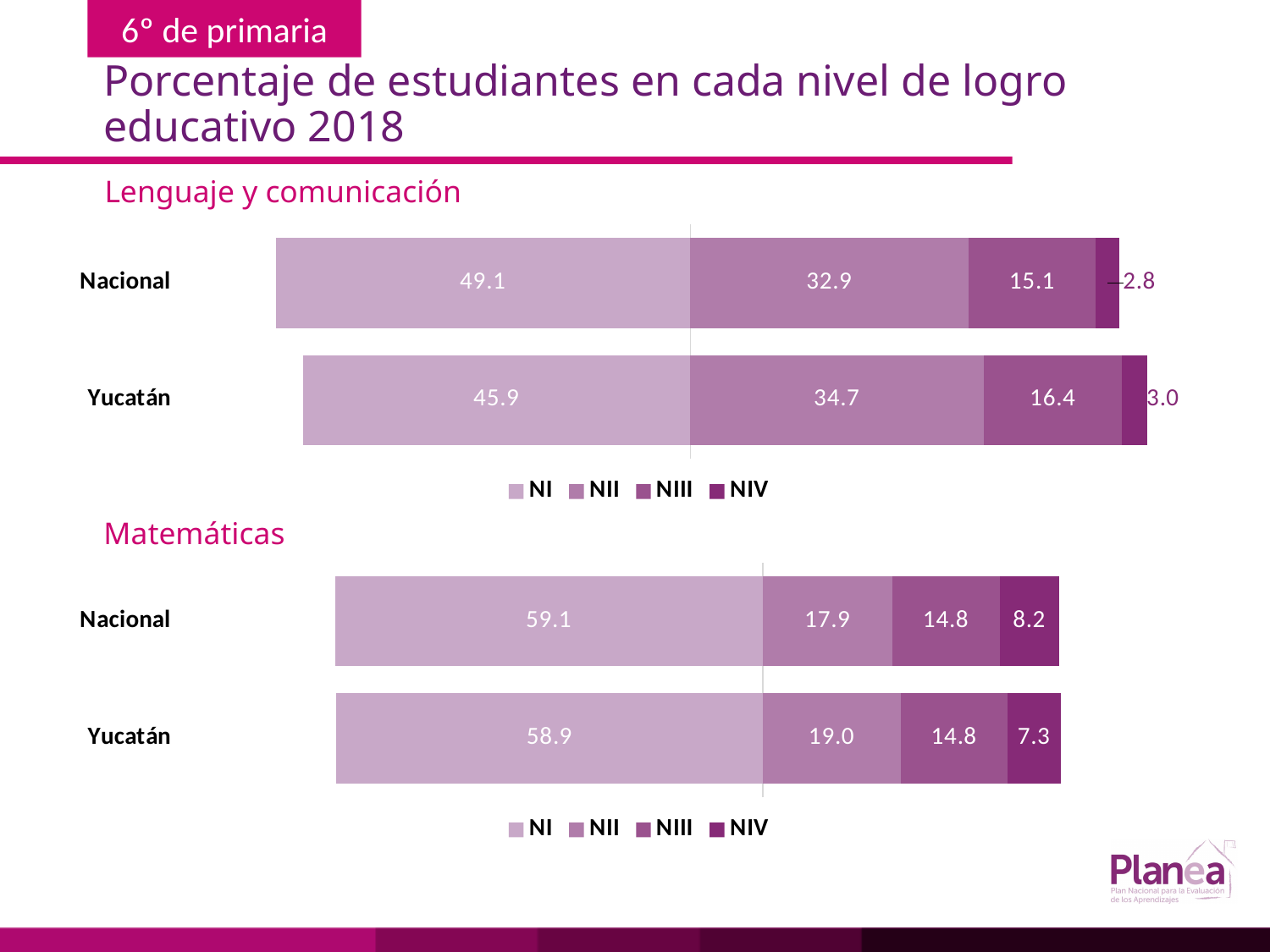
In the Matemáticas chart, what is the NIV value for Nacional? 8.2 In the Lenguaje y comunicación chart, what is the difference between the NI values for Nacional and Yucatán? 3.2 How many series does the legend of the Lenguaje y comunicación chart list? 4 How many categories (rows) are shown in the Lenguaje y comunicación chart? 2 In the Matemáticas chart, what is the NII value for Yucatán? 19.0 In the Lenguaje y comunicación chart, what is the NI value for Yucatán? 45.9 In the Matemáticas chart, which level has the lowest value for Yucatán? NIV In the Matemáticas chart, what is the total of the stacked bar for Yucatán? 100.0 In the Lenguaje y comunicación chart, what is the NIV value for Nacional? 2.8 In the Matemáticas chart, which is larger: the NIV value for Nacional or for Yucatán? Nacional What type of chart is the Matemáticas chart? Stacked bar chart In the Lenguaje y comunicación chart, which level has the highest value for Nacional? NI